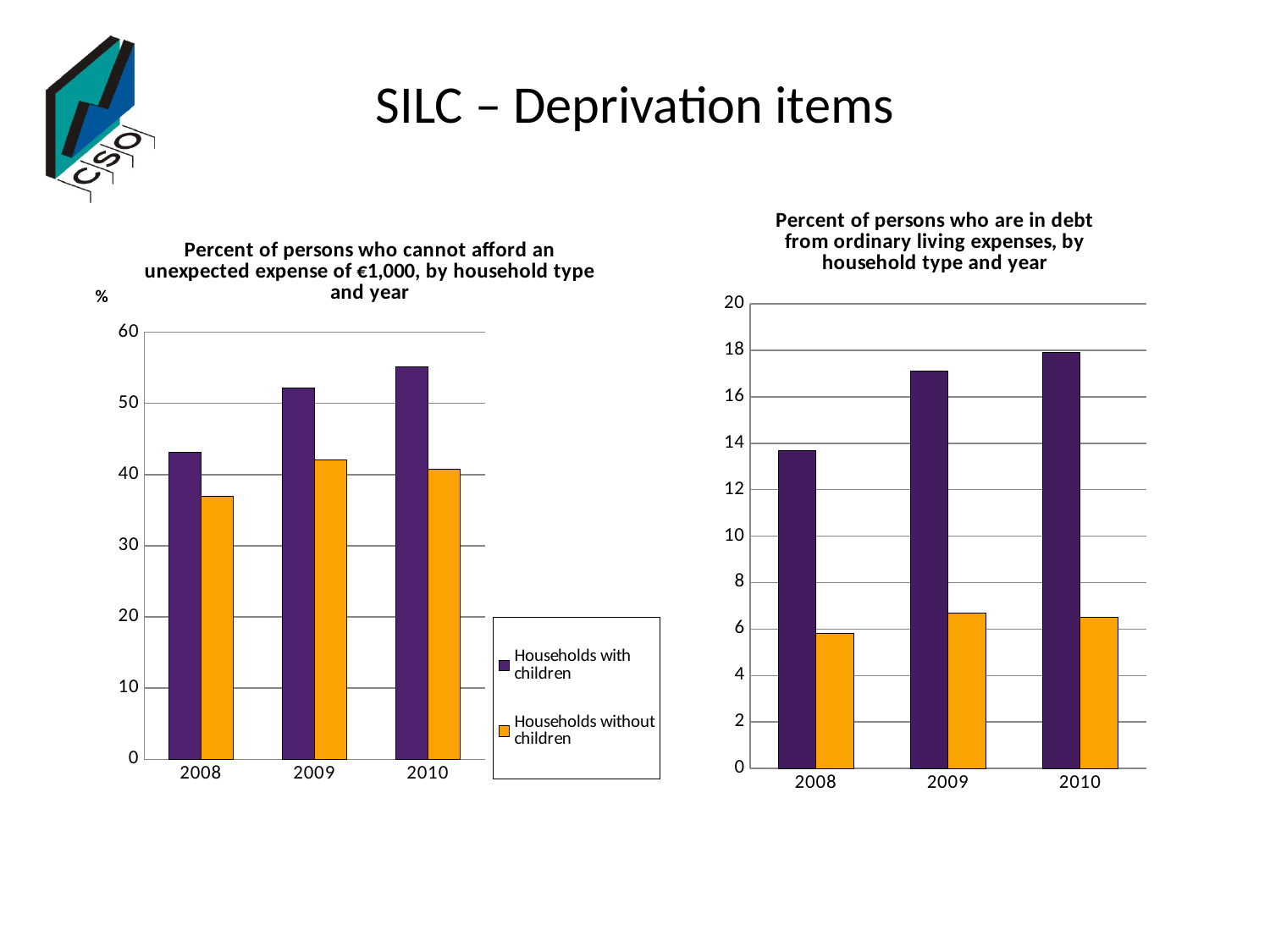
In the right chart, for 2009, which is larger: the purple bar (Households with children) or the orange bar (Households without children)? Households with children In the right chart, which year has the highest value for the purple bars (Households with children)? 2010 In the left chart, do the values for Households with children rise or fall from 2008 to 2010? rise In the left chart, which year has the highest value for Households with children? 2010 What is the title of the right chart? Percent of persons who are in debt from ordinary living expenses, by household type and year In the left chart, how many series does the legend list? 2 What kind of chart is the left chart, 'Percent of persons who cannot afford an unexpected expense of €1,000'? Bar chart In the right chart, is the value of the orange bar (Households without children) for 2008 greater or less than 8? less In the left chart, is the value for Households with children in 2008 greater or less than 40? greater In the left chart, how many years are shown on the x axis? 3 In the right chart, 'Percent of persons who are in debt from ordinary living expenses', is the value of the purple bar (Households with children) for 2008 greater or less than 12? greater